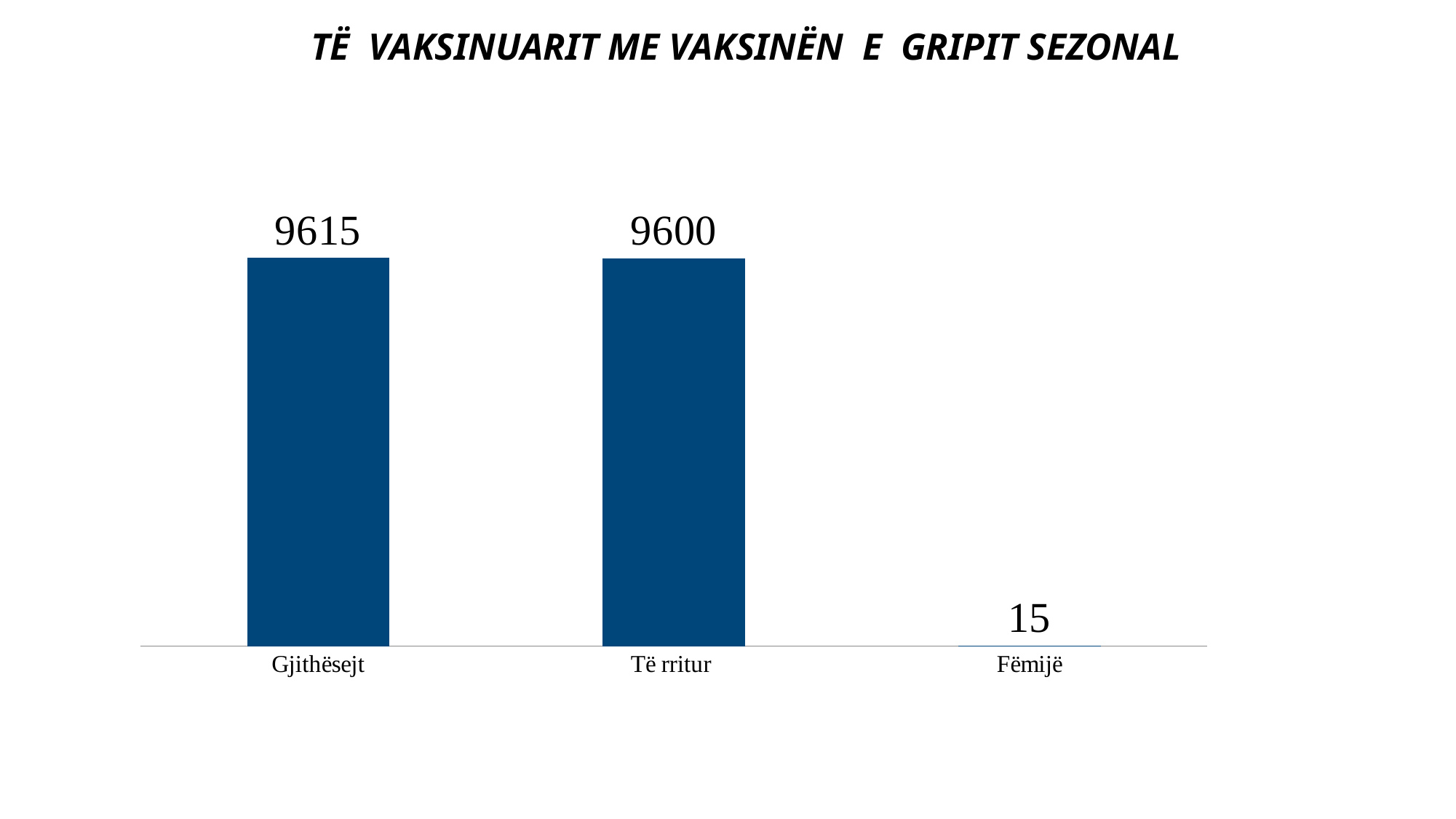
What colour are the bars in the chart? Dark blue What is the difference between the values for Gjithësejt and Të rritur? 15 What is the value for Gjithësejt? 9615 Which is larger, the value for Të rritur or the value for Fëmijë? Të rritur What is the difference between the values for Të rritur and Fëmijë? 9585 What kind of chart is shown on the slide? Bar chart Do the values rise or fall from left to right across the categories? Fall Which category has the lowest value? Fëmijë What is the value for Fëmijë? 15 What is the value for Të rritur? 9600 What is the title of the chart? TË VAKSINUARIT ME VAKSINËN E GRIPIT SEZONAL How many categories are shown on the chart? 3